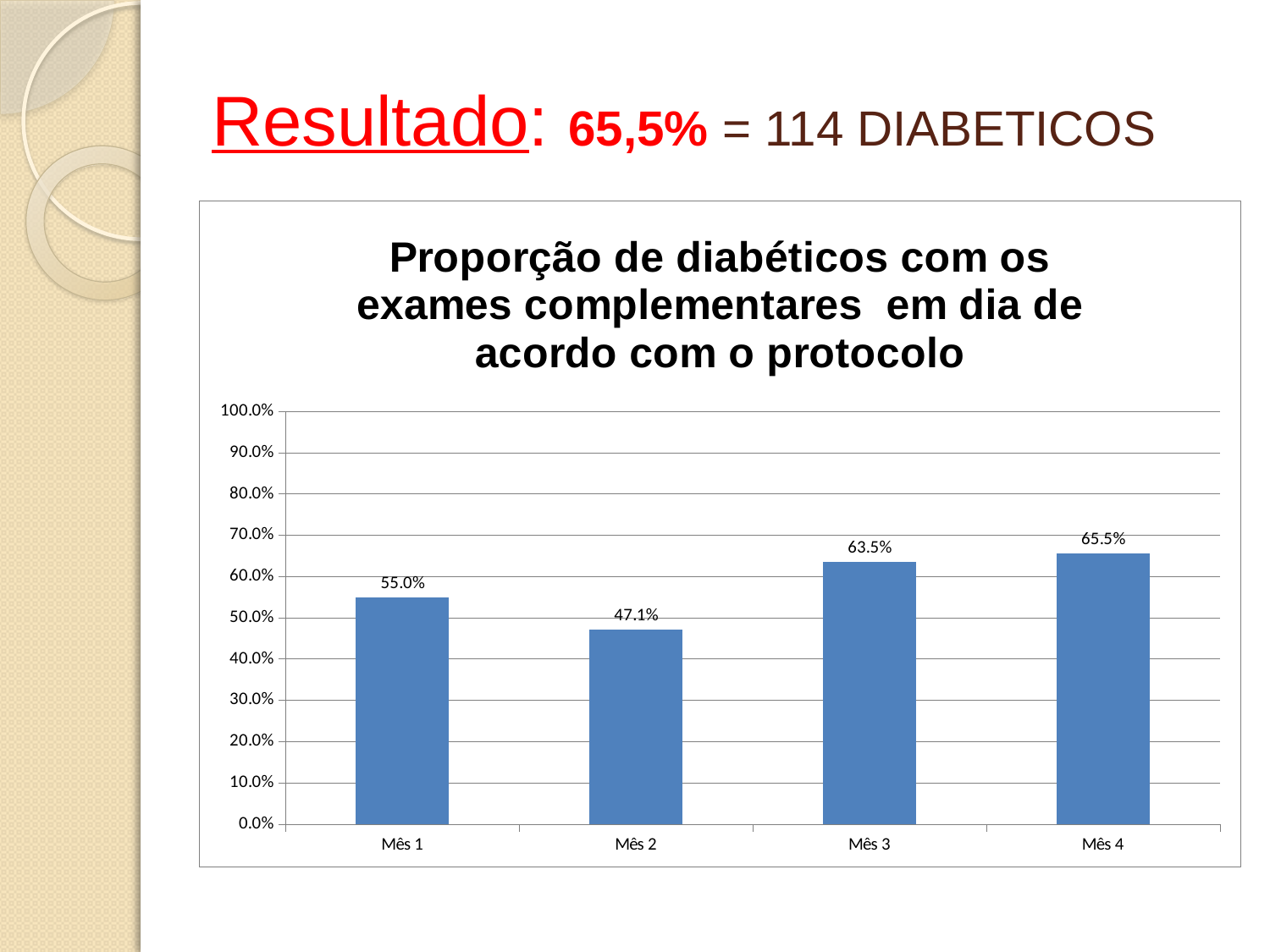
What is the title of the chart? Proporção de diabéticos com os exames complementares em dia de acordo com o protocolo What is the value for Mês 3? 63.5% What kind of chart is shown on the slide? Bar chart Which month has the highest value? Mês 4 What is the value for Mês 4? 65.5% How many months are shown on the x axis? 4 What is the value for Mês 1? 55.0% What is the difference between the values for Mês 4 and Mês 2? 18.4% Which is larger, the value for Mês 1 or the value for Mês 2? Mês 1 Which month has the lowest value? Mês 2 What is the difference between the values for Mês 3 and Mês 1? 8.5% What is the value for Mês 2? 47.1%